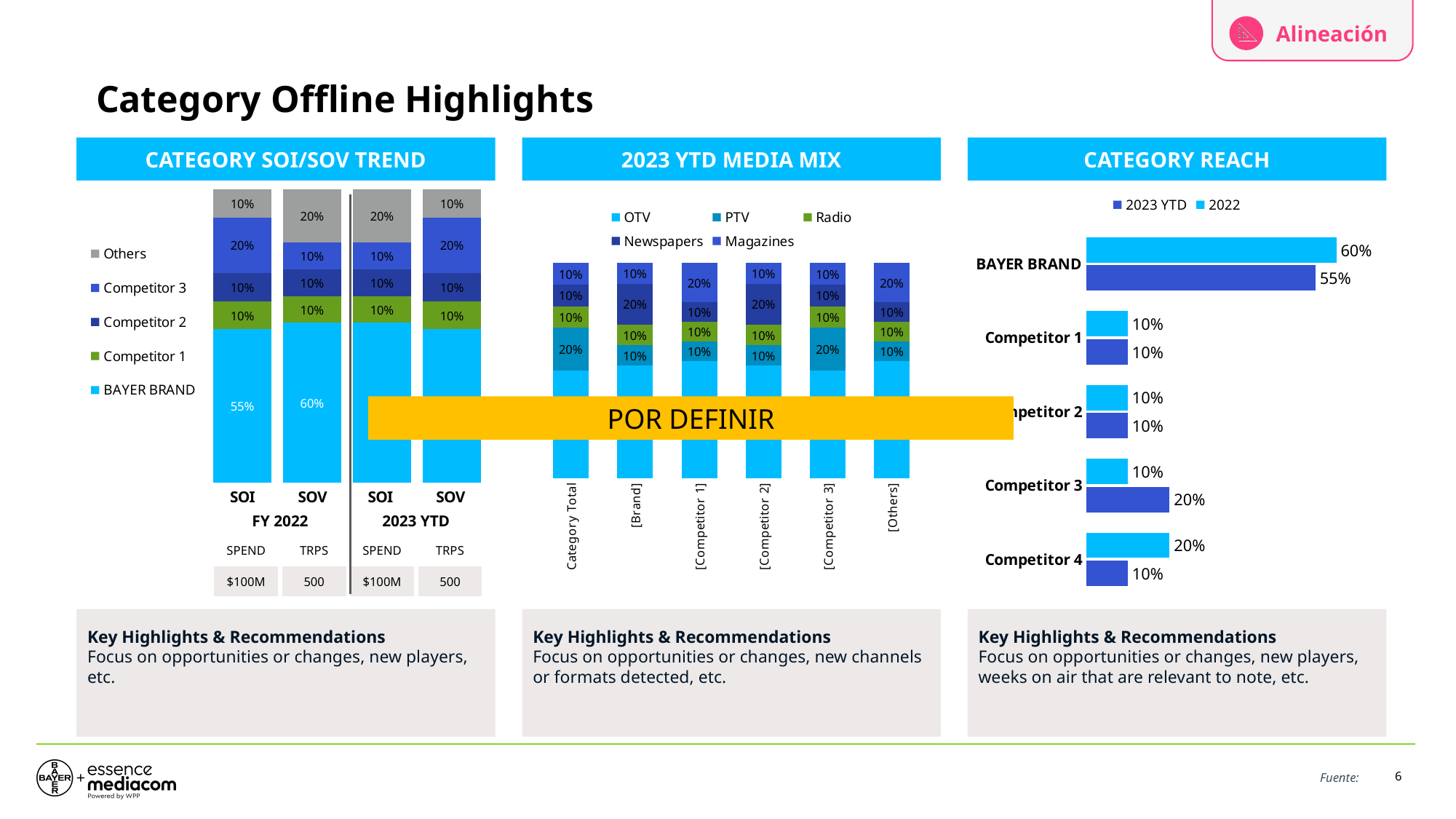
How many series does the legend of the CATEGORY REACH chart list? 2 In the CATEGORY REACH chart, which is larger for Competitor 4: the 2022 value or the 2023 YTD value? 2022 In the CATEGORY REACH chart, what is the 2023 YTD reach for Competitor 3? 20% In the CATEGORY REACH chart, what is the difference between BAYER BRAND's 2022 reach and its 2023 YTD reach? 5% In the 2023 YTD MEDIA MIX chart, what is the PTV share for Category Total? 20% What type of chart is the CATEGORY REACH chart? Bar chart How many series does the legend of the CATEGORY SOI/SOV TREND chart list? 5 In the CATEGORY REACH chart, what is the 2022 reach for BAYER BRAND? 60% In the CATEGORY SOI/SOV TREND chart, what is the Competitor 3 share in the SOI bar for FY 2022? 20% In the CATEGORY REACH chart, which category has the highest 2023 YTD reach? BAYER BRAND In the CATEGORY SOI/SOV TREND chart, what is the BAYER BRAND share in the SOV bar for FY 2022? 60% How many categories are shown on the x axis of the 2023 YTD MEDIA MIX chart? 6